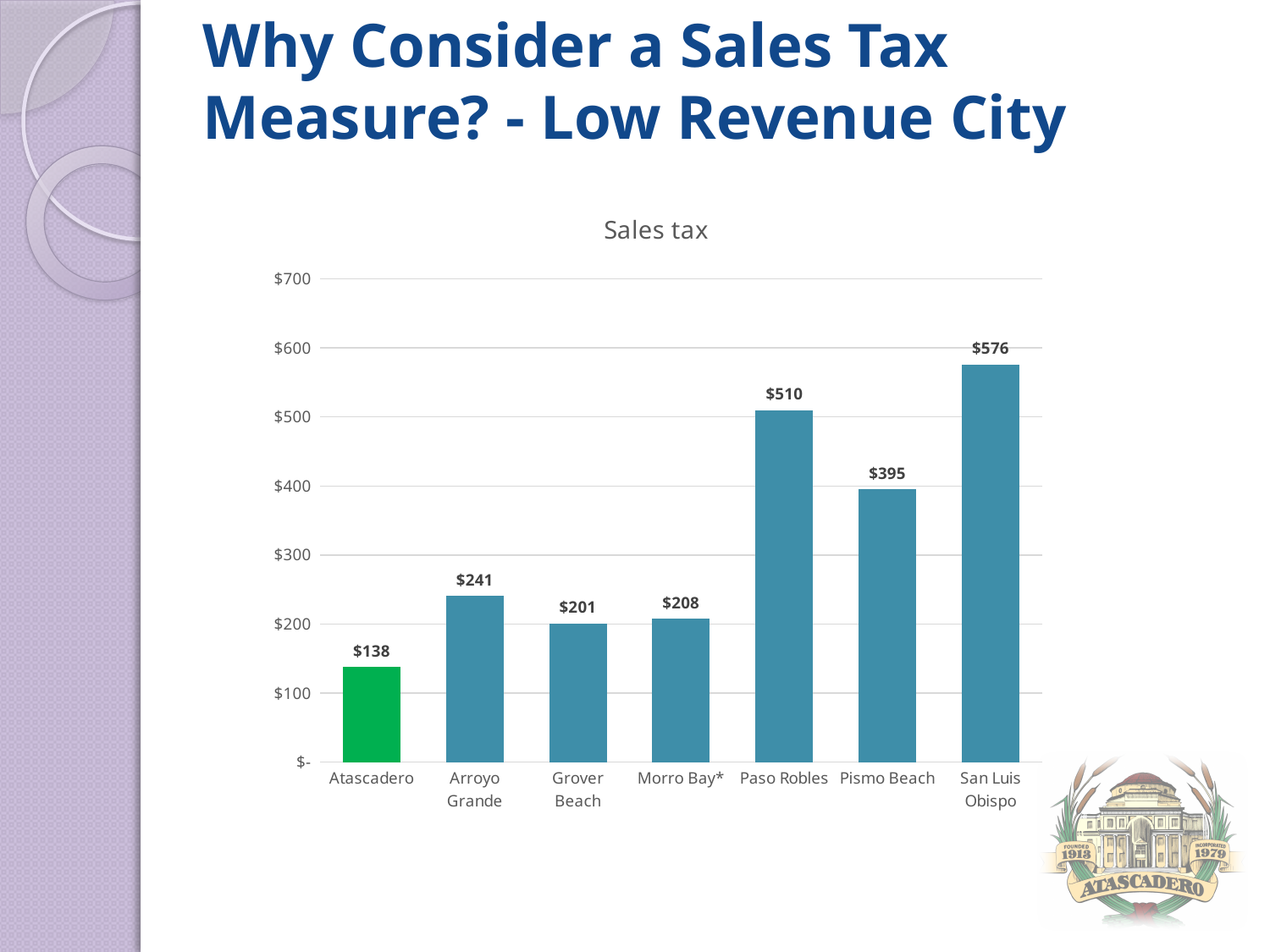
What kind of chart is shown on the slide? Bar chart What is the difference between the sales tax values for San Luis Obispo and Atascadero? $438 Which has a larger sales tax value, Pismo Beach or Paso Robles? Paso Robles How many cities are shown in the chart? 7 Is the value for Pismo Beach greater or less than $300? greater What is the sales tax value for Atascadero? $138 What is the difference between the sales tax values for Arroyo Grande and Grover Beach? $40 What is the sales tax value for Morro Bay*? $208 Which city has the highest sales tax value? San Luis Obispo Which city has the lowest sales tax value? Atascadero Which bar is coloured green rather than blue? Atascadero What is the sales tax value for Paso Robles? $510